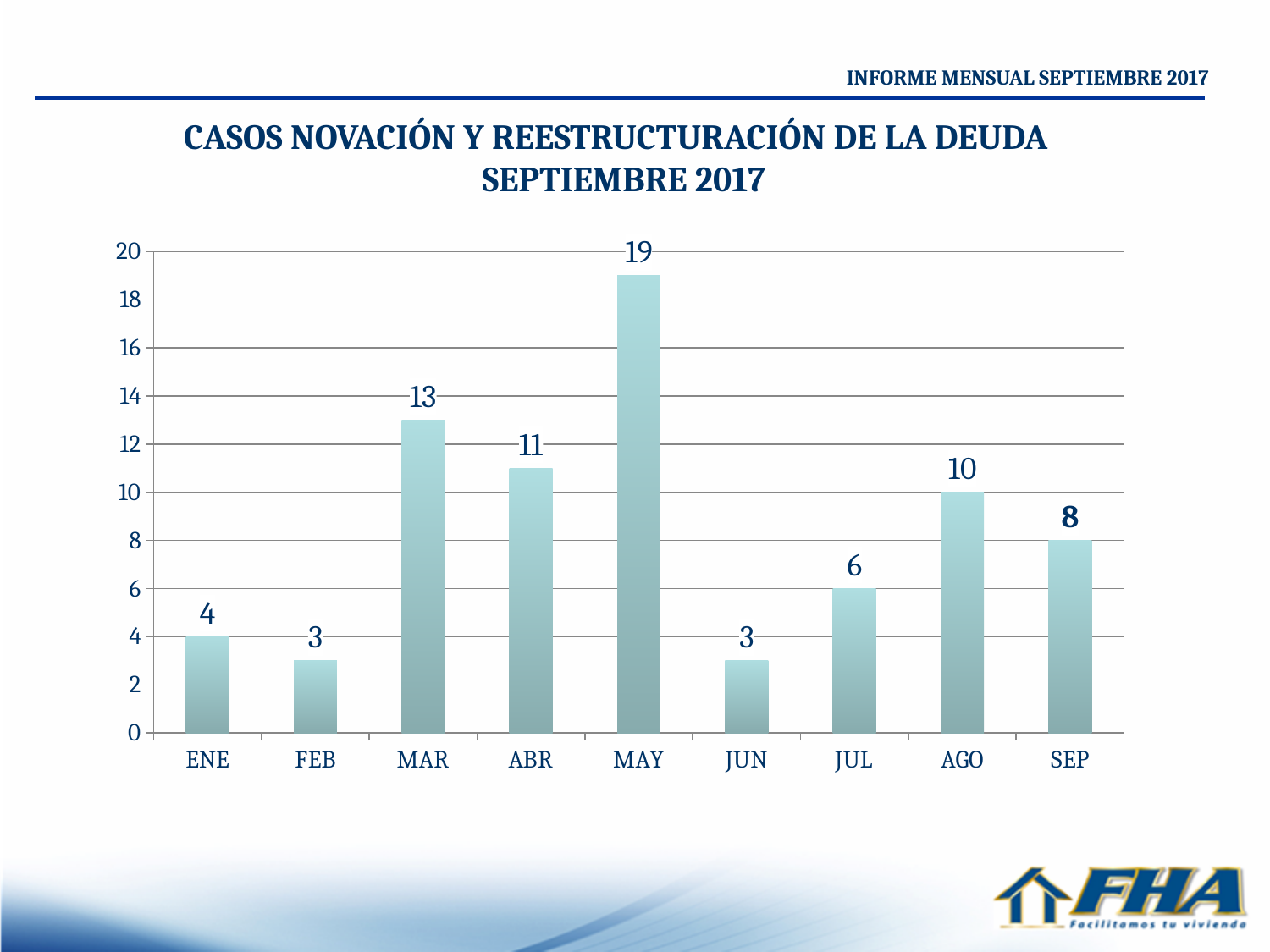
How many months are shown on the x axis? 9 Which is larger, the value for AGO or the value for JUL? AGO What is the title of the chart? CASOS NOVACIÓN Y REESTRUCTURACIÓN DE LA DEUDA SEPTIEMBRE 2017 What kind of chart is this? bar chart What is the value for SEP? 8 Which month has the lowest value? FEB and JUN Which month has the highest value? MAY Is the value for MAR greater or less than 12? greater What is the difference between the values for MAY and ABR? 8 What is the value for MAY? 19 What is the value for MAR? 13 Do the values rise or fall from JUN to AGO? rise